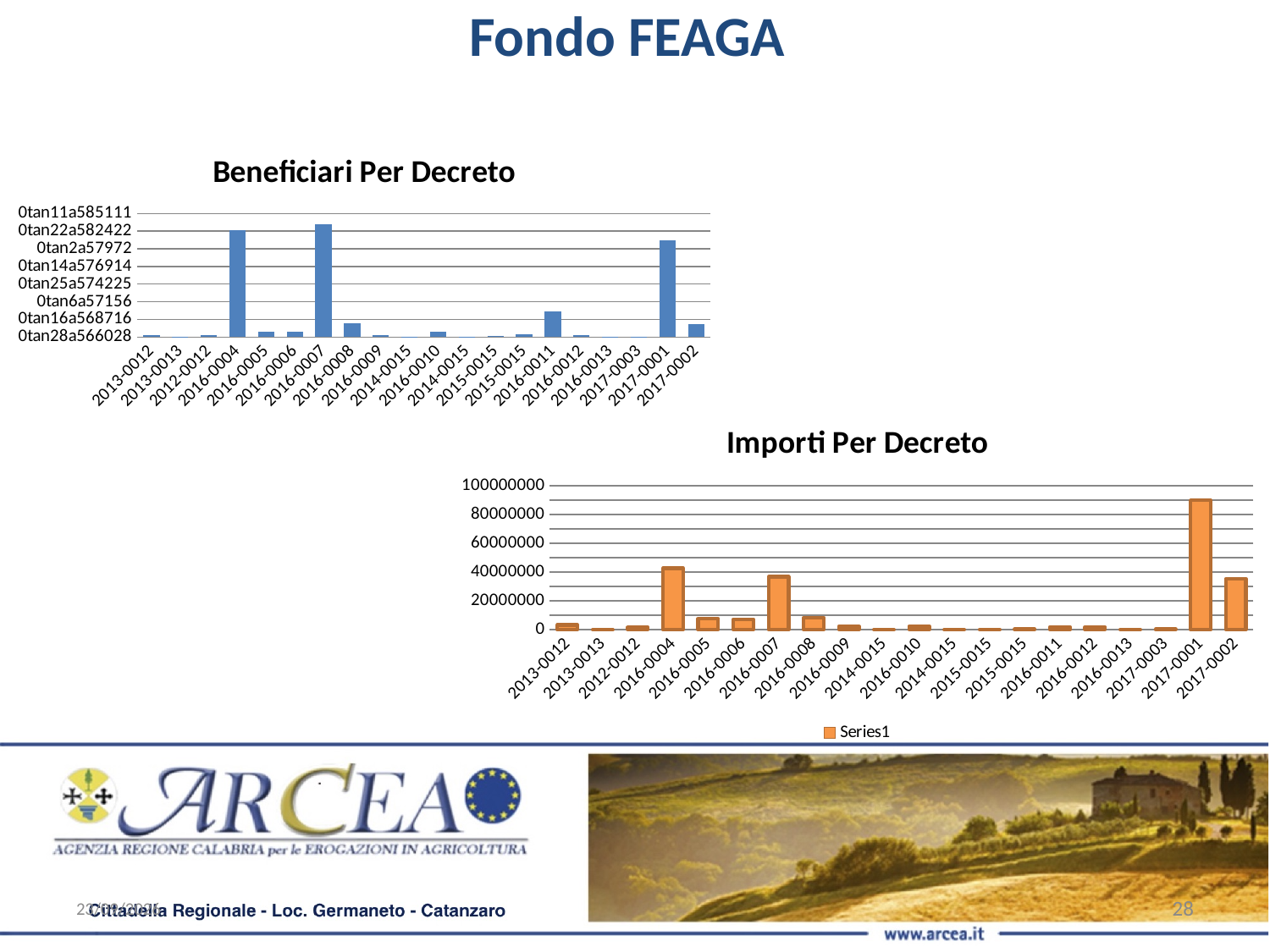
In the "Importi Per Decreto" chart, is the value for 2016-0005 greater or less than 20000000? less In the "Importi Per Decreto" chart, which category has the highest value? 2017-0001 What kind of chart is the "Beneficiari Per Decreto" chart? bar chart What kind of chart is the "Importi Per Decreto" chart? bar chart In the "Beneficiari Per Decreto" chart, which is larger, the value for 2016-0004 or the value for 2017-0001? 2016-0004 In the "Importi Per Decreto" chart, is the value for 2016-0007 greater or less than 40000000? less In the "Importi Per Decreto" chart, is the value for 2017-0001 greater or less than 80000000? greater In the "Importi Per Decreto" chart, which is larger, the value for 2016-0004 or the value for 2017-0002? 2016-0004 How many series does the legend of the "Importi Per Decreto" chart list? 1 What is the legend entry shown below the "Importi Per Decreto" chart? Series1 How many categories are plotted on the x axis of the "Importi Per Decreto" chart? 20 In the "Beneficiari Per Decreto" chart, which is larger, the value for 2016-0011 or the value for 2016-0008? 2016-0011